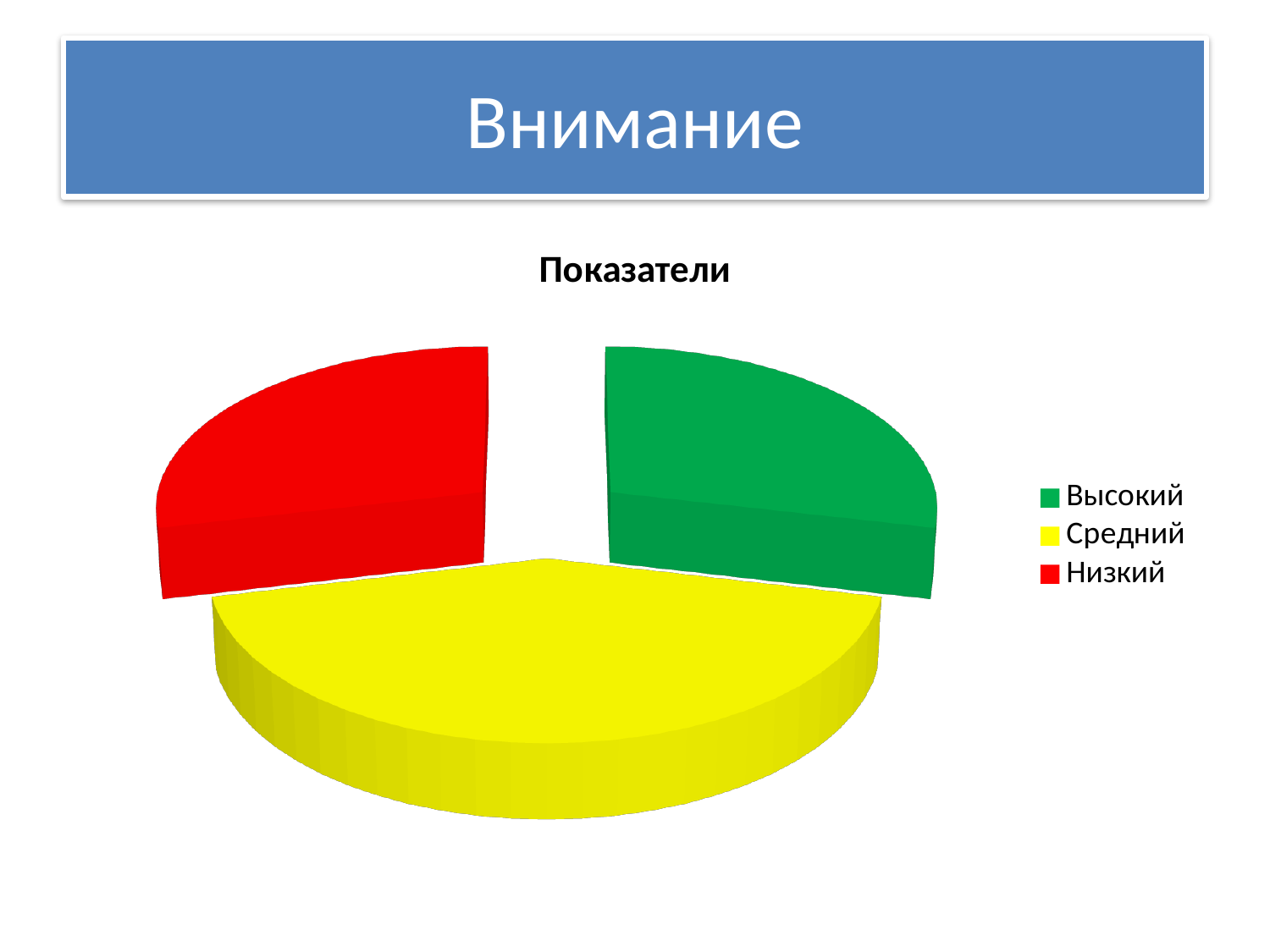
Which slice is larger, Низкий or Средний? Средний What kind of chart is shown on the slide? pie chart How many slices does the pie chart have? 3 Which category has the largest slice of the pie? Средний How many entries does the legend list? 3 What colour is the slice for Низкий? red What is the title of the chart? Показатели Which slice is larger, Средний or Высокий? Средний